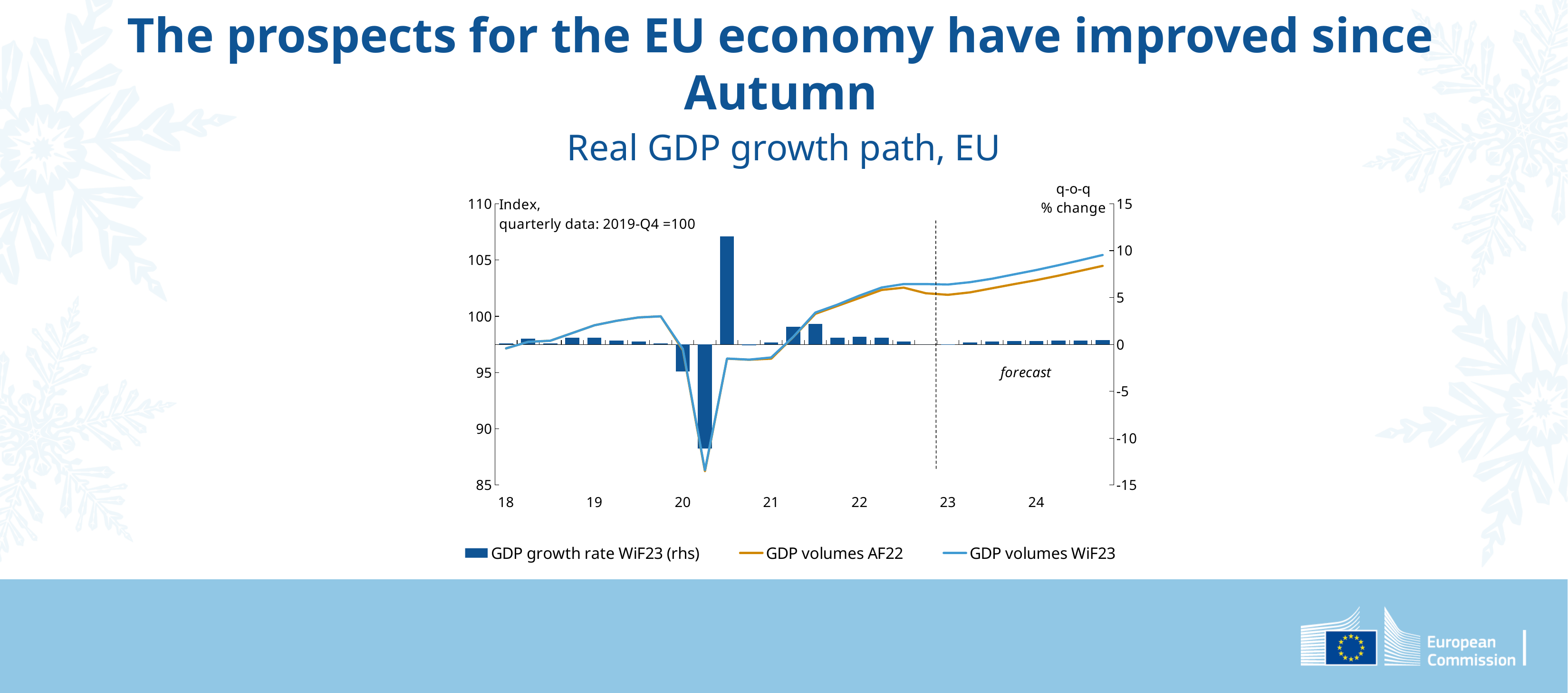
How many year labels are shown on the x axis? 7 What is the base period of the index on the left axis? 2019-Q4 =100 Is the value of the GDP volumes WiF23 line at the end of 2024 greater or less than 100 on the left axis? greater What is the title of the chart? Real GDP growth path, EU Is the tallest GDP growth rate WiF23 bar in 2020 greater or less than 10 on the right axis? greater What kind of chart is shown on the slide? Combined bar and line chart At the end of 2024, which line is higher: GDP volumes AF22 or GDP volumes WiF23? GDP volumes WiF23 How many series does the chart legend list? 3 Which series in the legend is plotted as bars? GDP growth rate WiF23 (rhs) Does the GDP volumes WiF23 line rise or fall over the forecast period from 2023 to 2024? rise Is the value of the GDP volumes AF22 line at the start of 2023 greater or less than 100 on the left axis? greater